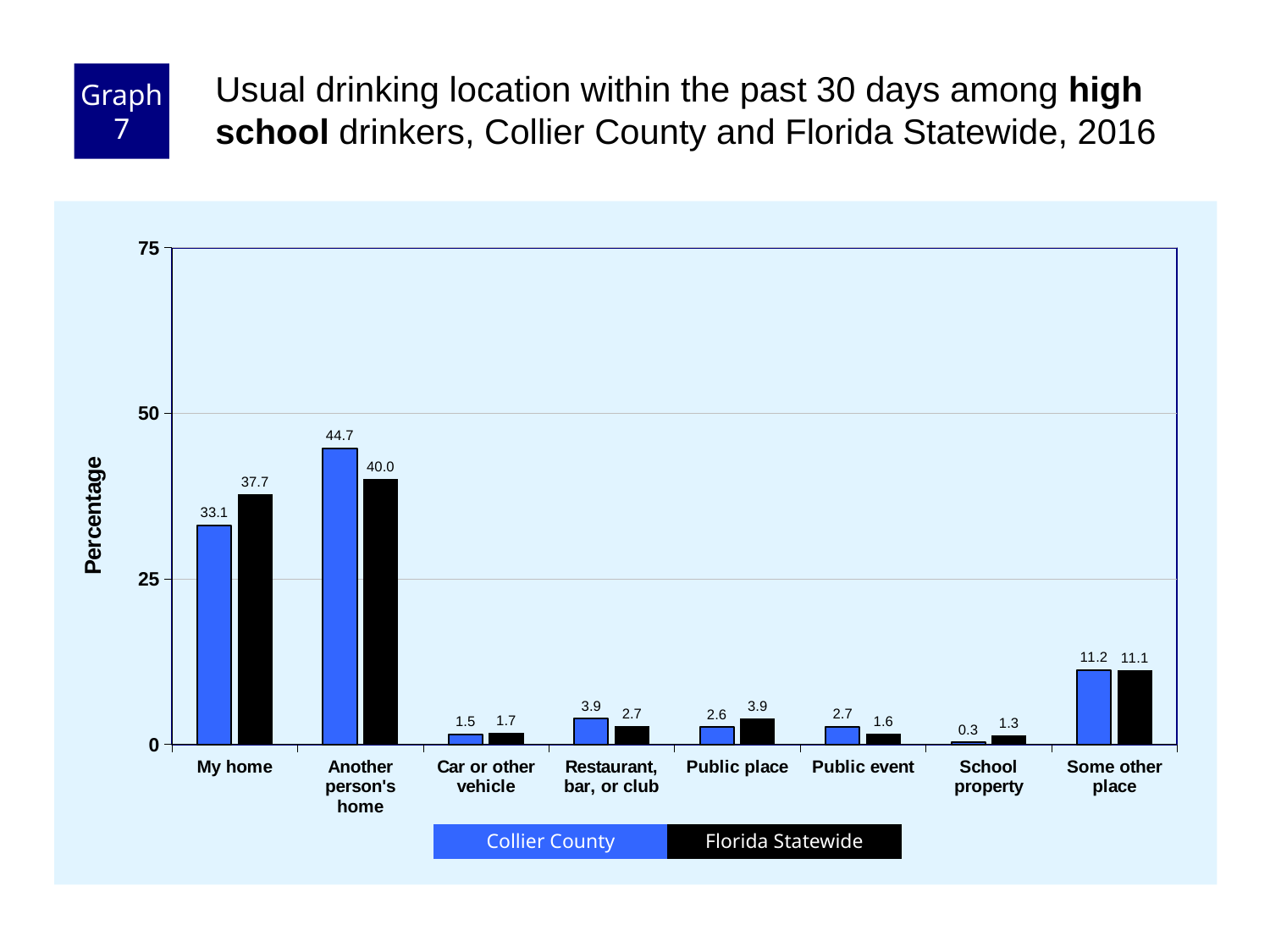
What kind of chart is shown on the slide? Bar chart What is the Collier County value for "Another person's home"? 44.7 How many categories are shown on the x axis? 8 How many series does the legend list? 2 Which is larger for "Public place": Collier County or Florida Statewide? Florida Statewide Which category has the lowest Florida Statewide value? School property What is the Florida Statewide value for "My home"? 37.7 What is the label on the y axis? Percentage What is the Collier County value for "School property"? 0.3 Which category has the highest Collier County value? Another person's home Is the Collier County value for "My home" greater or less than 25? greater What is the difference between the Collier County and Florida Statewide values for "Another person's home"? 4.7